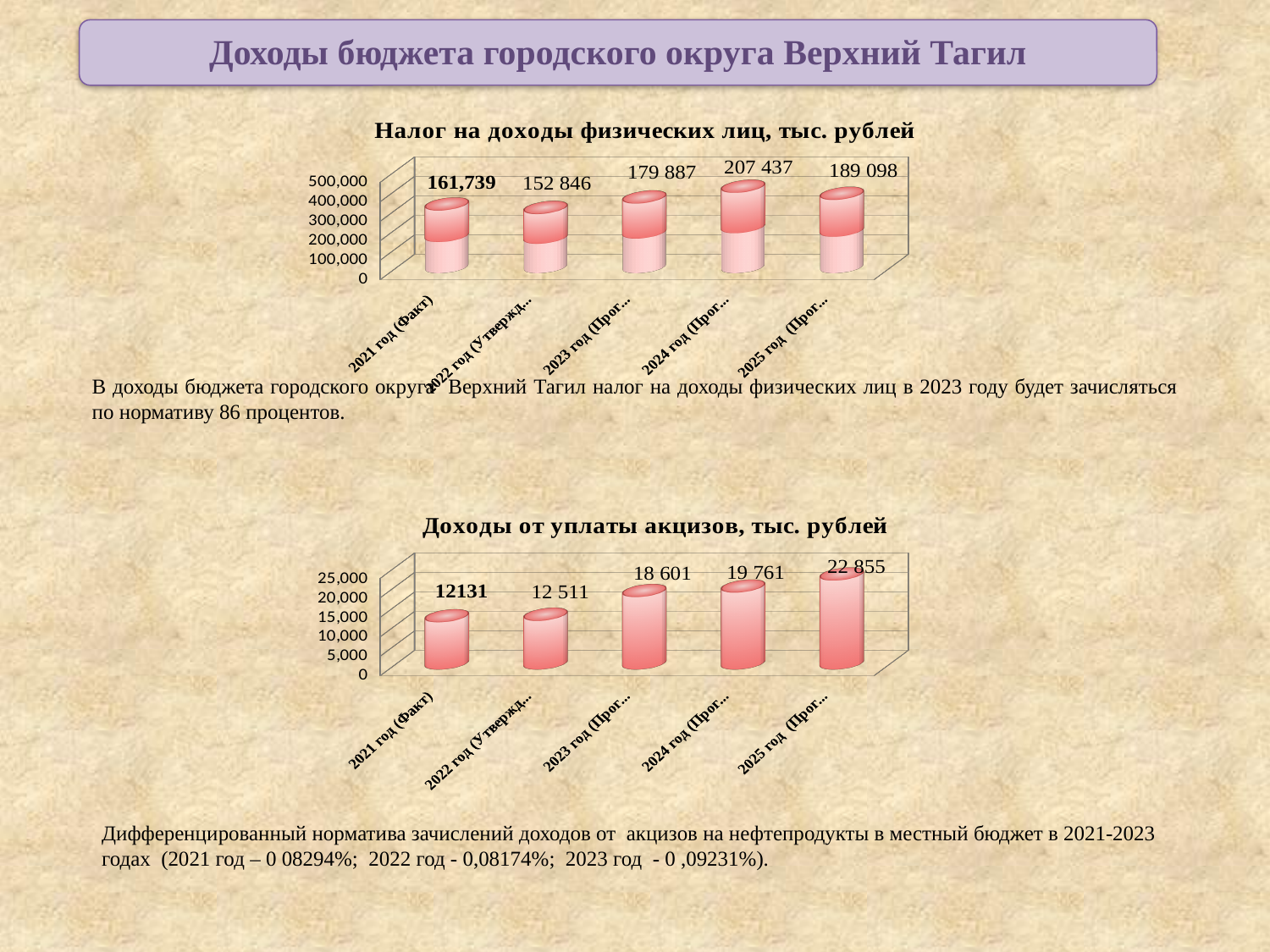
In the chart 'Налог на доходы физических лиц, тыс. рублей', is the value for 2023 год greater or less than 200,000? less In the chart 'Доходы от уплаты акцизов, тыс. рублей', do the values generally rise or fall from 2021 to 2025? rise In the chart 'Налог на доходы физических лиц, тыс. рублей', how many bars are plotted? 5 In the chart 'Налог на доходы физических лиц, тыс. рублей', which year has the highest value? 2024 год What type of chart is 'Доходы от уплаты акцизов, тыс. рублей'? bar chart In the chart 'Доходы от уплаты акцизов, тыс. рублей', which is larger: the value for 2024 год or the value for 2025 год? 2025 год In the chart 'Налог на доходы физических лиц, тыс. рублей', which year has the lowest value? 2022 год In the chart 'Доходы от уплаты акцизов, тыс. рублей', what is the value for 2025 год? 22 855 In the chart 'Доходы от уплаты акцизов, тыс. рублей', which year has the lowest value? 2021 год (Факт) In the chart 'Доходы от уплаты акцизов, тыс. рублей', what is the value for 2023 год? 18 601 In the chart 'Налог на доходы физических лиц, тыс. рублей', what is the value for 2021 год (Факт)? 161,739 In the chart 'Налог на доходы физических лиц, тыс. рублей', what is the value for 2024 год? 207 437